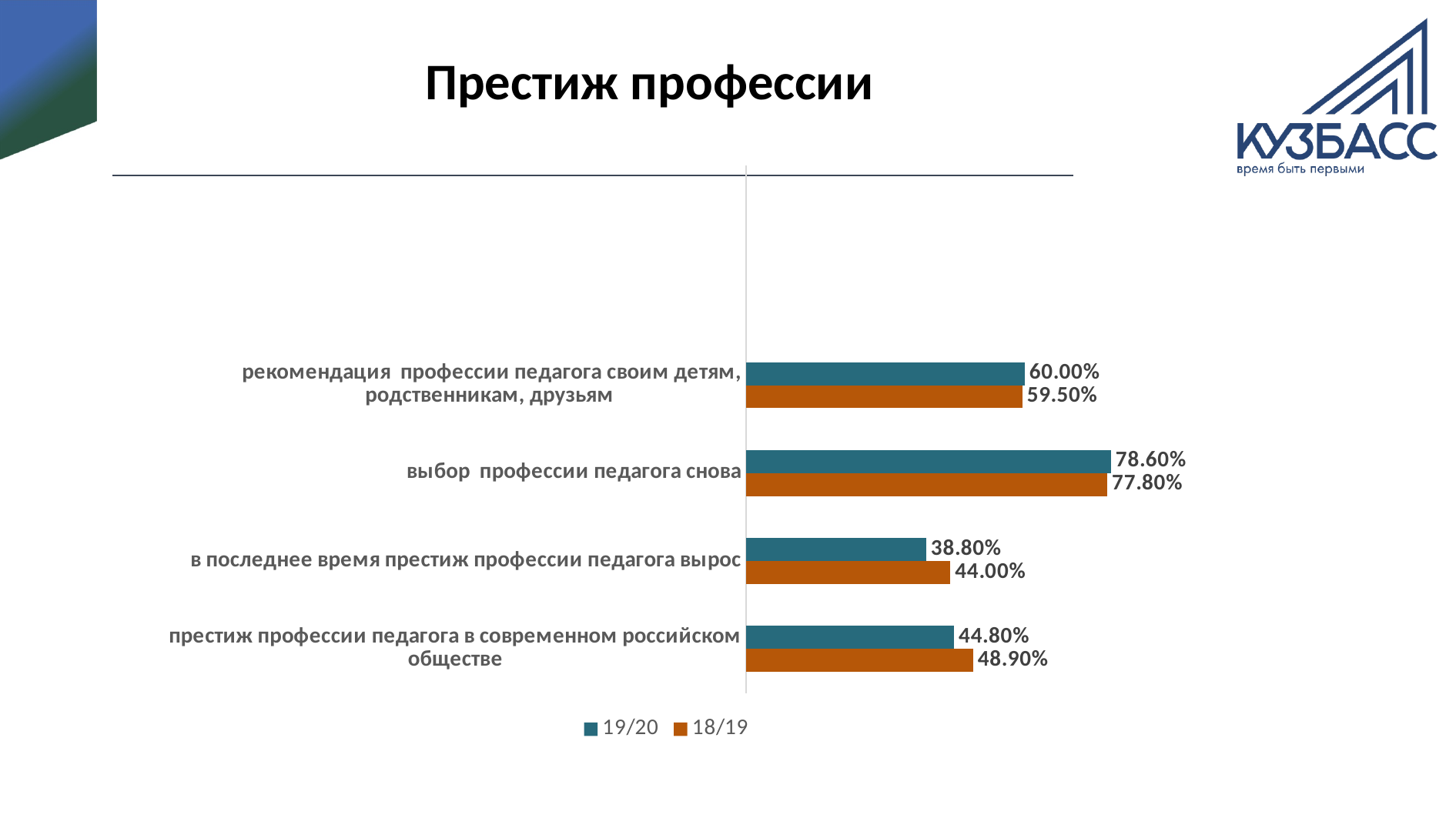
How many series does the legend list? 2 What is the 18/19 value for "престиж профессии педагога в современном российском обществе"? 48.90% What is the difference between the 18/19 and 19/20 values for "в последнее время престиж профессии педагога вырос"? 5.20% What type of chart is shown on the slide? bar chart What is the 19/20 value for "рекомендация профессии педагога своим детям, родственникам, друзьям"? 60.00% For "престиж профессии педагога в современном российском обществе", which series has the larger value, 19/20 or 18/19? 18/19 Which category has the highest 19/20 value? выбор профессии педагога снова What is the 18/19 value for "в последнее время престиж профессии педагога вырос"? 44.00% What is the title of the slide? Престиж профессии How many categories are shown in the chart? 4 What is the 19/20 value for "выбор профессии педагога снова"? 78.60% Which category has the lowest 18/19 value? в последнее время престиж профессии педагога вырос